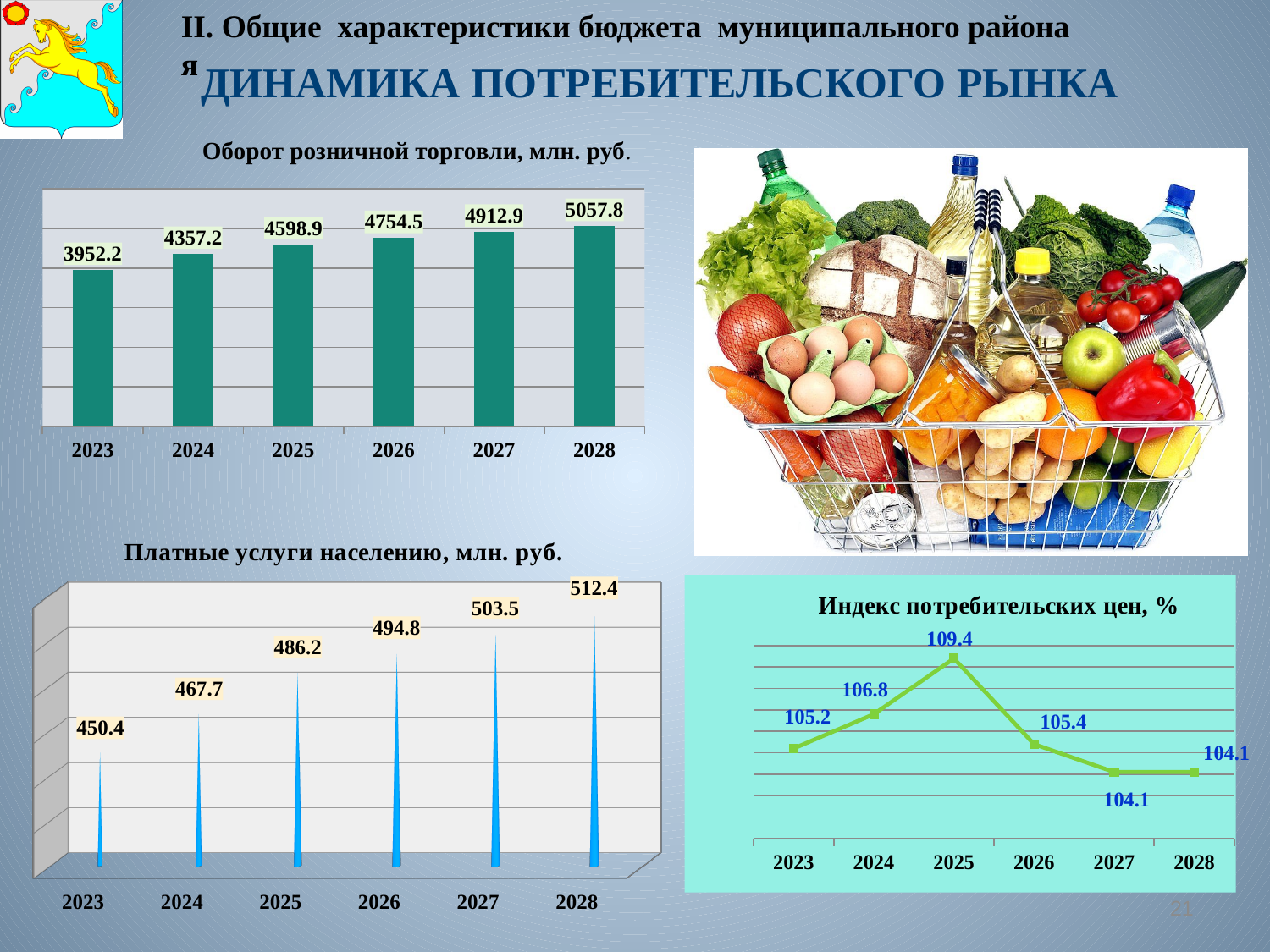
In the chart 'Платные услуги населению, млн. руб.', how many years are shown on the x axis? 6 In the chart 'Оборот розничной торговли, млн. руб.', what is the value for 2028? 5057.8 In the chart 'Оборот розничной торговли, млн. руб.', what is the value for 2023? 3952.2 In the chart 'Индекс потребительских цен, %', which is larger, the value for 2024 or the value for 2026? 2024 In the chart 'Платные услуги населению, млн. руб.', what is the value for 2025? 486.2 In the chart 'Индекс потребительских цен, %', which year has the highest value? 2025 In the chart 'Оборот розничной торговли, млн. руб.', what is the difference between the values for 2024 and 2023? 405.0 In the chart 'Платные услуги населению, млн. руб.', which year has the lowest value? 2023 In the chart 'Оборот розничной торговли, млн. руб.', which year has the highest value? 2028 In the chart 'Индекс потребительских цен, %', what is the value for 2025? 109.4 What kind of chart is 'Индекс потребительских цен, %'? line chart In the chart 'Оборот розничной торговли, млн. руб.', do the values rise or fall from 2023 to 2028? rise